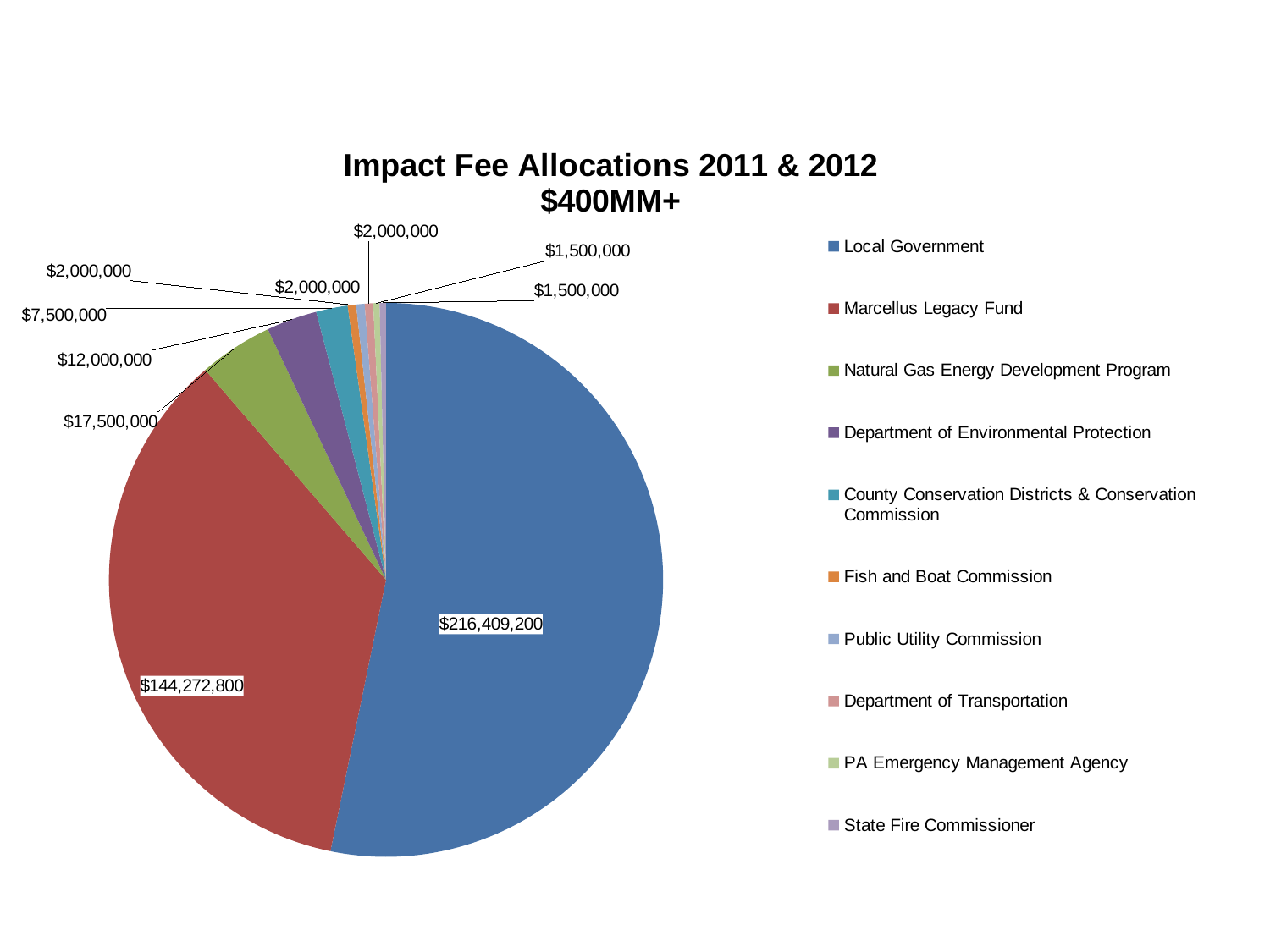
What is the value for the Department of Environmental Protection? $12,000,000 What kind of chart is shown on the slide? Pie chart Which category has the largest slice of the pie? Local Government What is the value for Local Government? $216,409,200 What is the value for County Conservation Districts & Conservation Commission? $7,500,000 How many categories does the legend list? 10 What is the title of the chart? Impact Fee Allocations 2011 & 2012 $400MM+ Which legend entry is shown in blue? Local Government What is the difference between the Local Government and Marcellus Legacy Fund allocations? $72,136,400 What is the value for the Marcellus Legacy Fund? $144,272,800 What is the value for the Natural Gas Energy Development Program? $17,500,000 Which is larger, the allocation to the Natural Gas Energy Development Program or to the Department of Environmental Protection? Natural Gas Energy Development Program